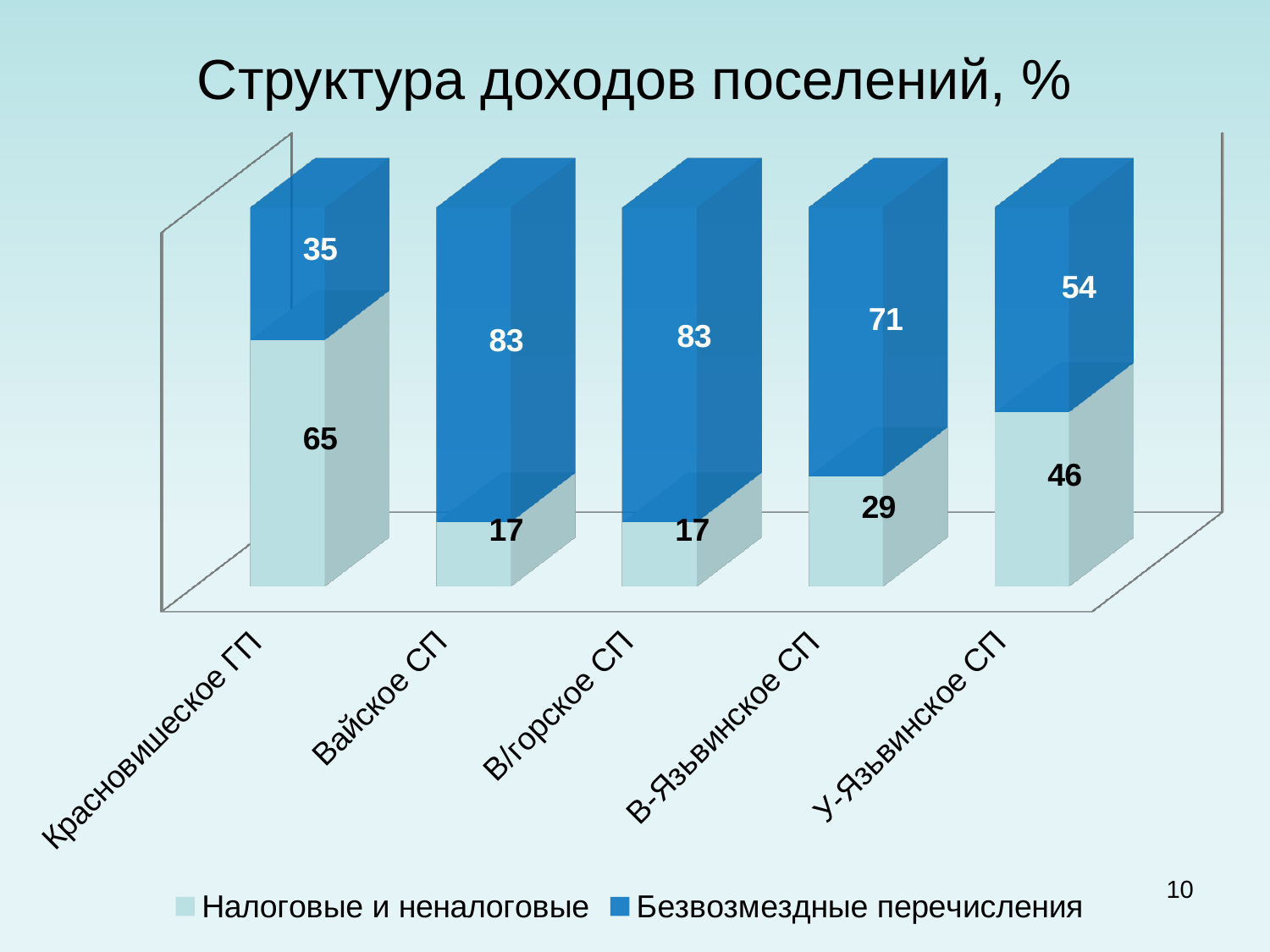
Which category has the lowest value for "Безвозмездные перечисления"? Красновишерское ГП What is the total of the stacked bar for В/горское СП? 100 What is the value of "Налоговые и неналоговые" for У-Язьвинское СП? 46 What kind of chart is shown on the slide? Stacked bar chart How many categories are shown on the x axis? 5 What is the difference between the "Безвозмездные перечисления" values for В-Язьвинское СП and У-Язьвинское СП? 17 What is the value of "Налоговые и неналоговые" for Красновишерское ГП? 65 What is the value of "Безвозмездные перечисления" for В-Язьвинское СП? 71 How many series does the legend list? 2 Which category has the highest value for "Налоговые и неналоговые"? Красновишерское ГП Which is larger: the "Налоговые и неналоговые" value for В-Язьвинское СП or for У-Язьвинское СП? У-Язьвинское СП What is the value of "Безвозмездные перечисления" for Вайское СП? 83